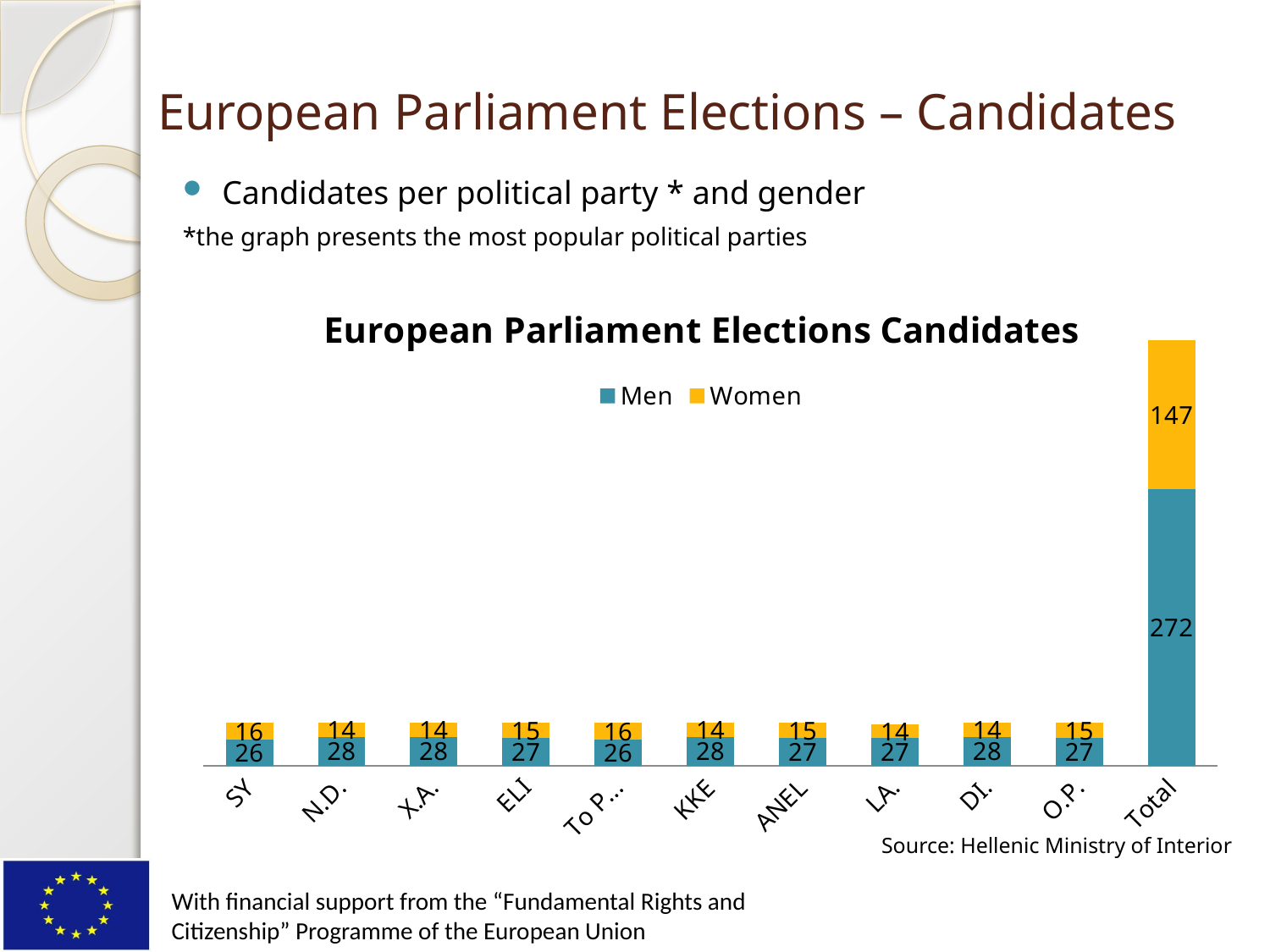
What type of chart is shown on the slide? stacked bar chart Which category has the highest stacked bar? Total How many series does the legend list? 2 What is the value for Men in the Total bar? 272 Which two series are shown in the legend? Men and Women What is the value for Men for KKE? 28 What is the total of the stacked bar for Total? 419 How many categories are shown on the x axis? 11 What is the value for Women in the Total bar? 147 What is the total of the stacked bar for N.D.? 42 What is the difference between Men and Women in the Total bar? 125 What is the value for Women for SY? 16